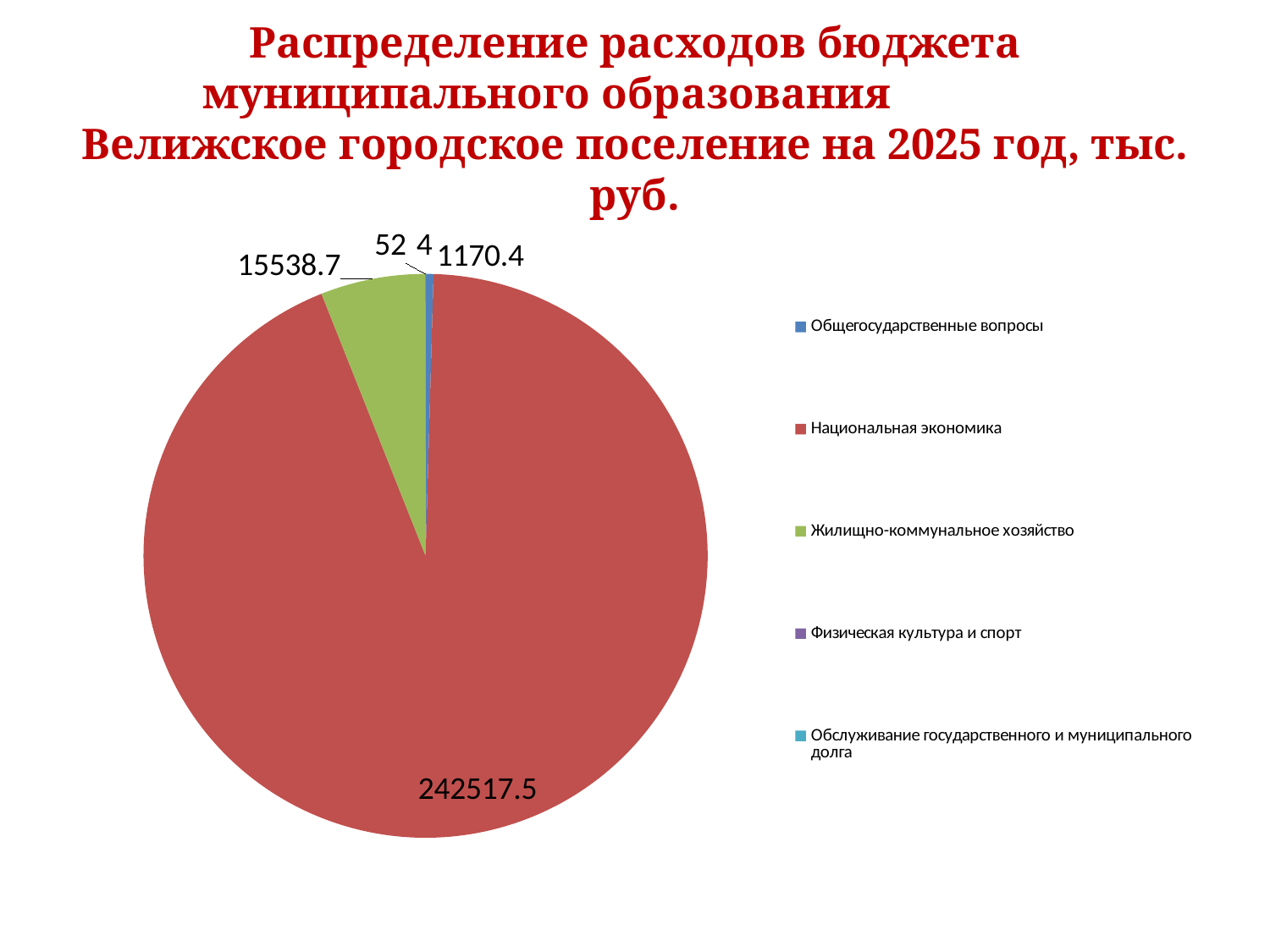
What is the value for Жилищно-коммунальное хозяйство? 15538.7 Which category has the largest share of the pie? Национальная экономика How many categories does the legend of the pie chart list? 5 What is the difference between the values for Жилищно-коммунальное хозяйство and Общегосударственные вопросы? 14368.3 What is the difference between the values for Национальная экономика and Жилищно-коммунальное хозяйство? 226978.8 For which year does the slide title say the budget expenditures are distributed? 2025 What is the value for Национальная экономика? 242517.5 Which is larger: Жилищно-коммунальное хозяйство or Общегосударственные вопросы? Жилищно-коммунальное хозяйство What colour is the slice for Национальная экономика? red What kind of chart is shown on the slide? pie chart What is the value for Общегосударственные вопросы? 1170.4